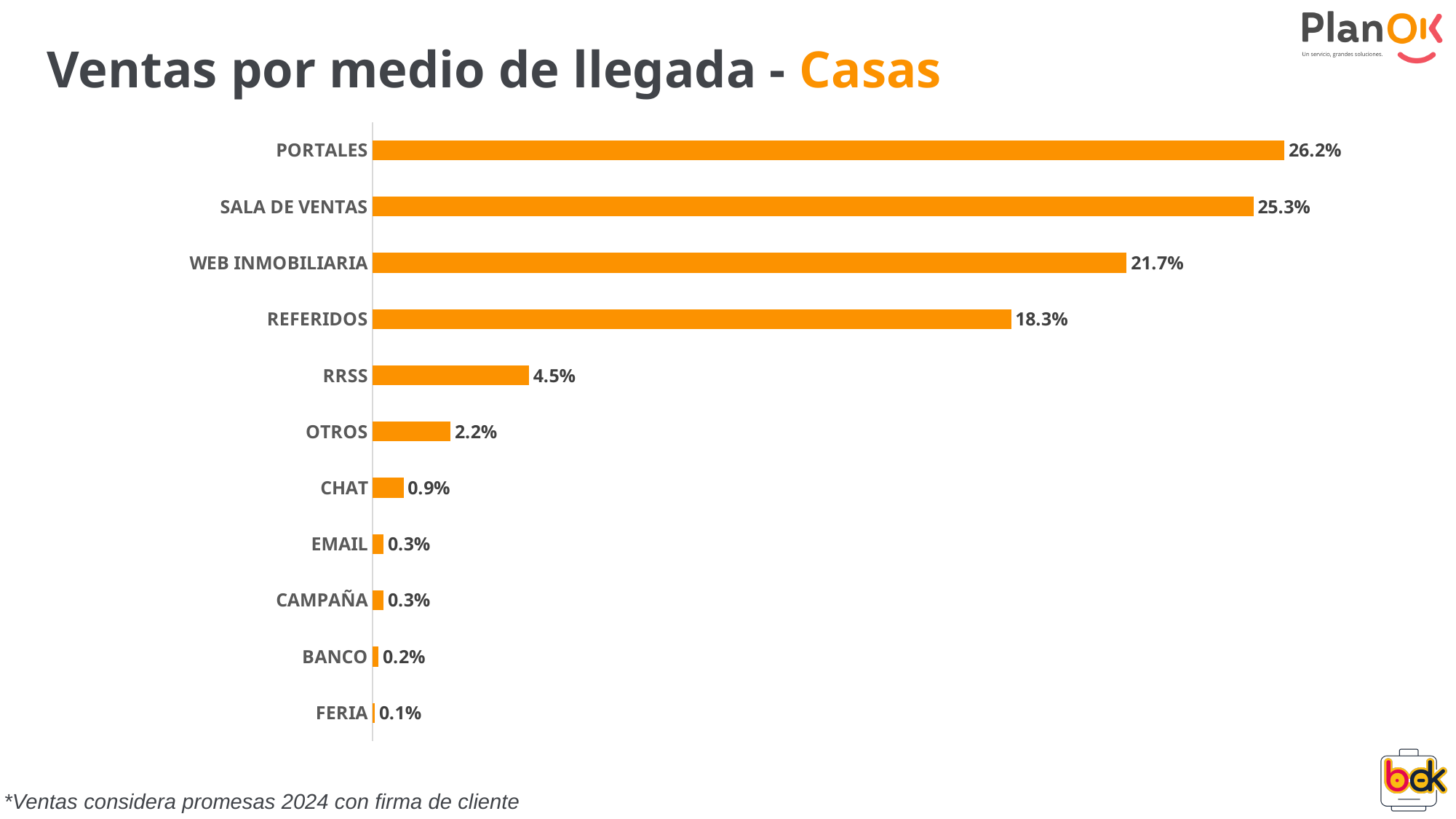
Which category has the lowest value? FERIA Which category has the highest value? PORTALES What colour are the bars in the chart? Orange Which is larger, the value for RRSS or the value for OTROS? RRSS What is the value for CHAT? 0.9% What is the value for REFERIDOS? 18.3% What is the difference between the values for PORTALES and SALA DE VENTAS? 0.9% What kind of chart is shown on the slide? Bar chart What is the title of the slide? Ventas por medio de llegada - Casas What is the difference between the values for WEB INMOBILIARIA and REFERIDOS? 3.4% How many categories are shown in the chart? 11 What is the value for PORTALES? 26.2%